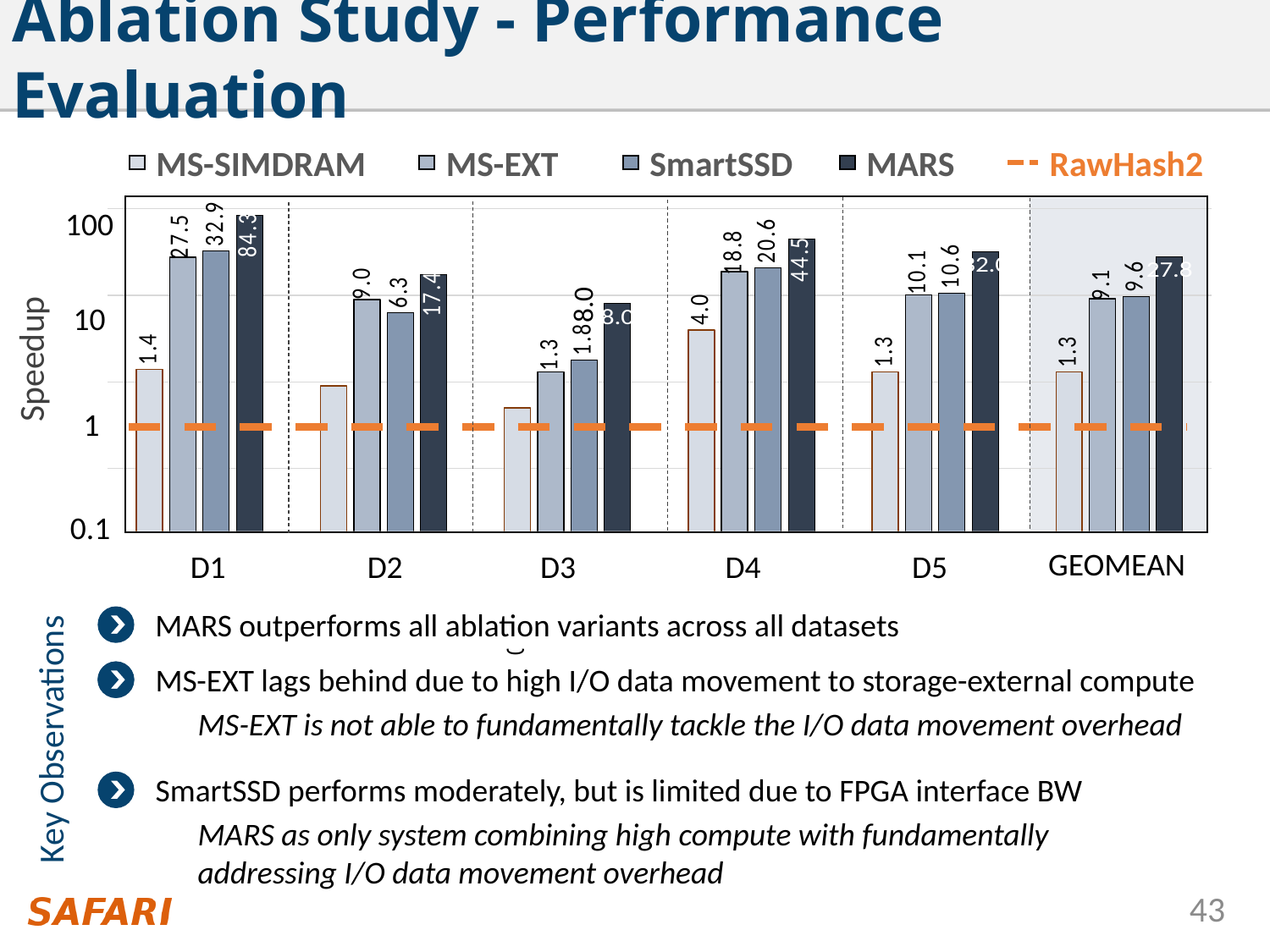
Is the speedup of MS-SIMDRAM on dataset D2 greater or less than 10? less Which system has the highest speedup on dataset D1? MARS What kind of chart is shown on the slide? bar chart Which system has the lowest speedup on dataset D4? MS-SIMDRAM What is the difference between the MARS and SmartSSD speedups on dataset D1? 51.4 What is the speedup of MS-SIMDRAM on dataset D4? 4.0 What is the speedup of SmartSSD on dataset D2? 6.3 On dataset D2, which has the larger speedup, MS-EXT or SmartSSD? MS-EXT How many dataset categories are shown on the x axis? 6 What is the speedup of MARS on dataset D1? 84.3 How many entries does the legend list? 5 What is the speedup of MS-EXT on dataset D4? 18.8